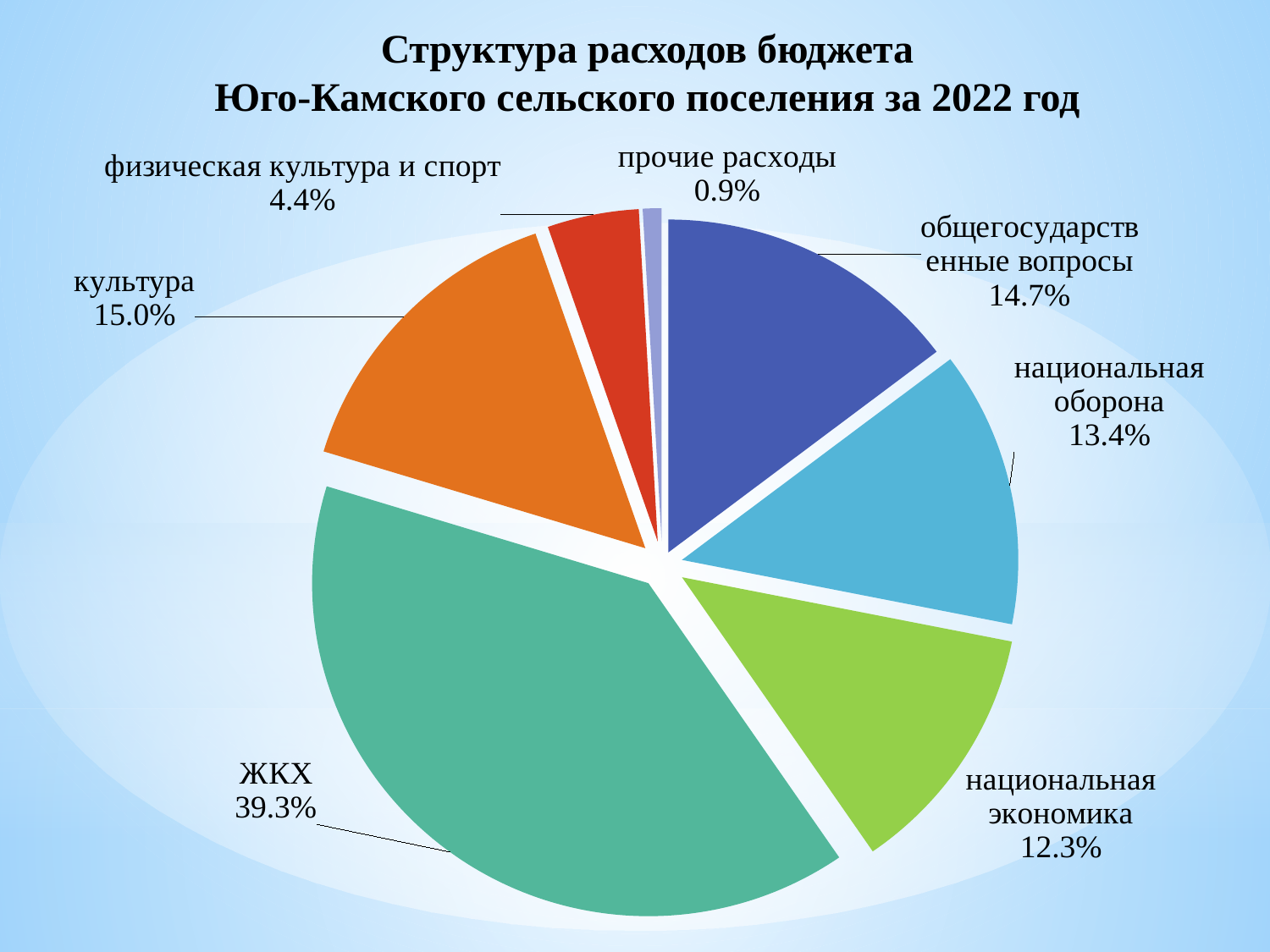
What is the value for прочие расходы? 0.9% What year does the chart title say the budget expenditure structure refers to? 2022 Which category has the largest share of the pie? ЖКХ What share of budget expenditure goes to ЖКХ? 39.3% What is the difference between the shares of культура and национальная экономика? 2.7% How many slices does the pie chart have? 7 Which is larger: общегосударственные вопросы or физическая культура и спорт? общегосударственные вопросы Which category has the smallest share of the pie? прочие расходы What kind of chart is shown on the slide? pie chart What is the difference between the shares of ЖКХ and общегосударственные вопросы? 24.6% What percentage is shown for культура? 15.0% What is the value shown for национальная оборона? 13.4%